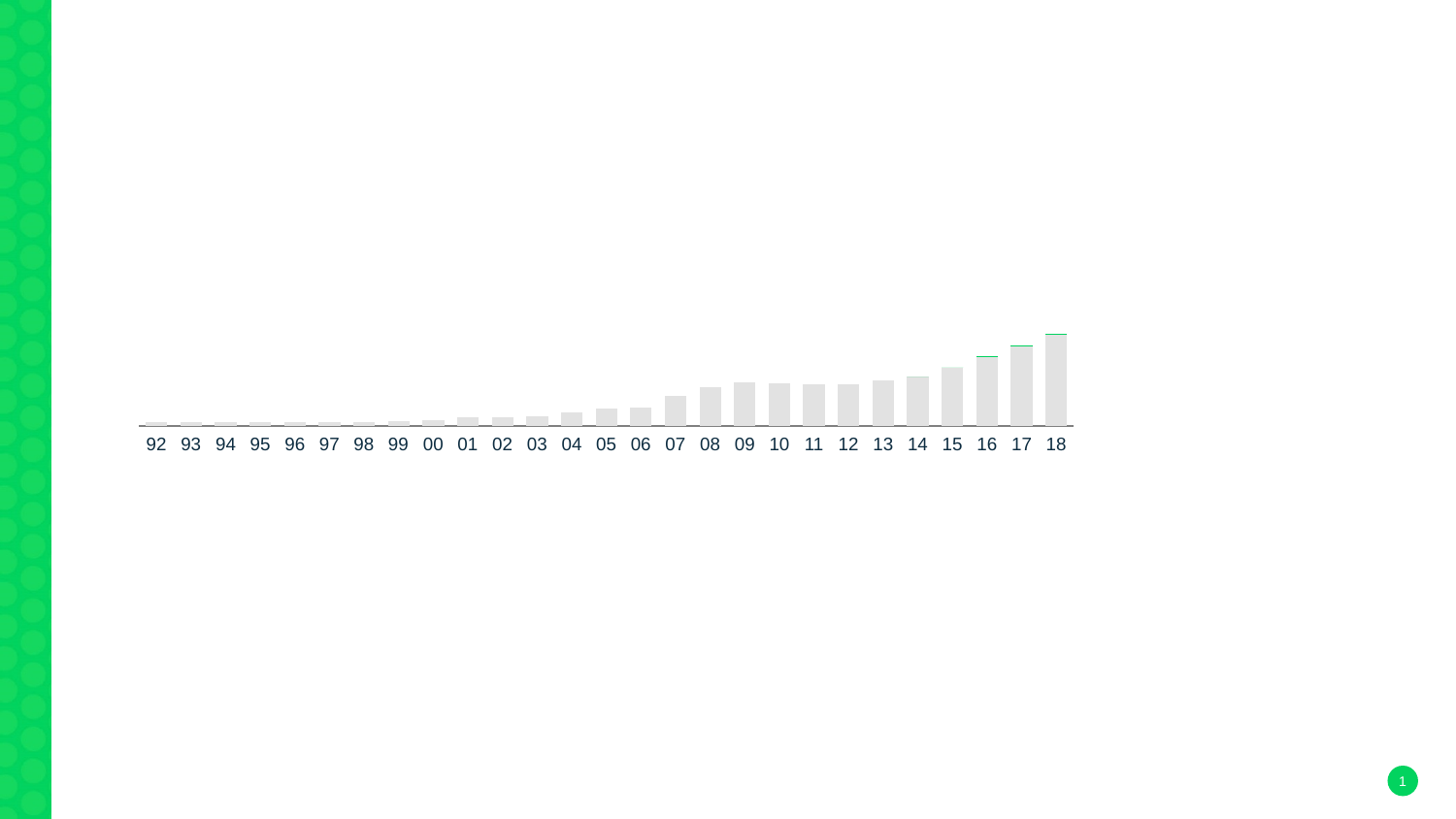
What kind of chart is shown on the slide? bar chart Which year has the tallest bar in the chart? 18 What colour is the cap on top of the bars for 17 and 18? green Which bar is taller, 18 or 14? 18 Which bar is taller, 08 or 04? 08 How many years (bars) are shown along the x axis of the chart? 27 Do the bar values generally rise or fall from 92 to 18? rise Which bar is taller, 15 or 11? 15 What is the first year label on the x axis of the chart? 92